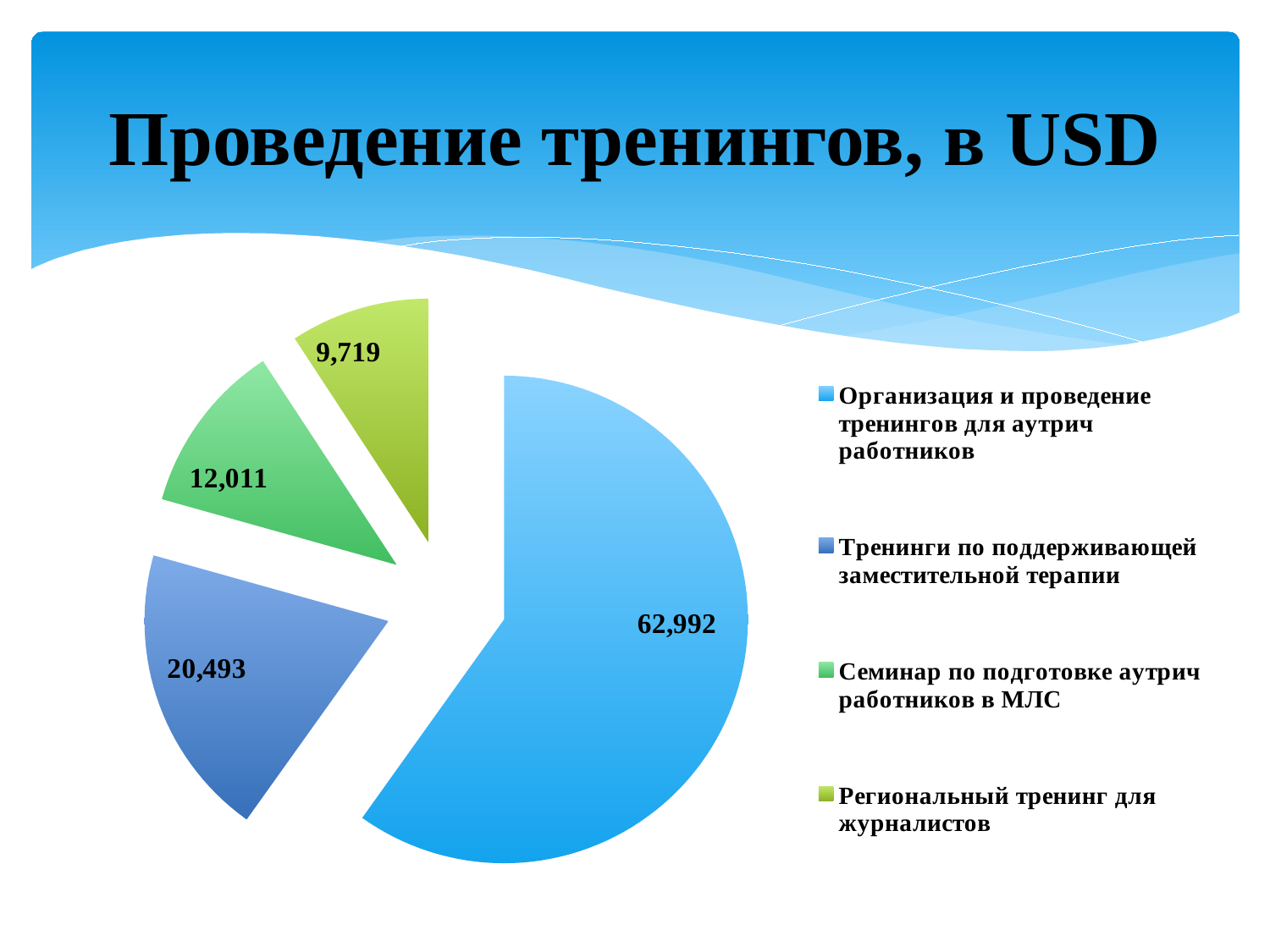
What is the title of the slide containing the chart? Проведение тренингов, в USD What type of chart is shown on the slide? Pie chart Which category has the largest slice of the pie? Организация и проведение тренингов для аутрич работников Which is larger: the value for "Семинар по подготовке аутрич работников в МЛС" or for "Региональный тренинг для журналистов"? Семинар по подготовке аутрич работников в МЛС What is the difference between the values for "Организация и проведение тренингов для аутрич работников" and "Тренинги по поддерживающей заместительной терапии"? 42,499 How many slices does the pie chart have? 4 What is the value for "Тренинги по поддерживающей заместительной терапии"? 20,493 What is the total of all the values shown in the pie chart? 105,215 Which category has the smallest slice of the pie? Региональный тренинг для журналистов What is the value for "Региональный тренинг для журналистов"? 9,719 What is the value for "Семинар по подготовке аутрич работников в МЛС"? 12,011 What is the value for "Организация и проведение тренингов для аутрич работников"? 62,992